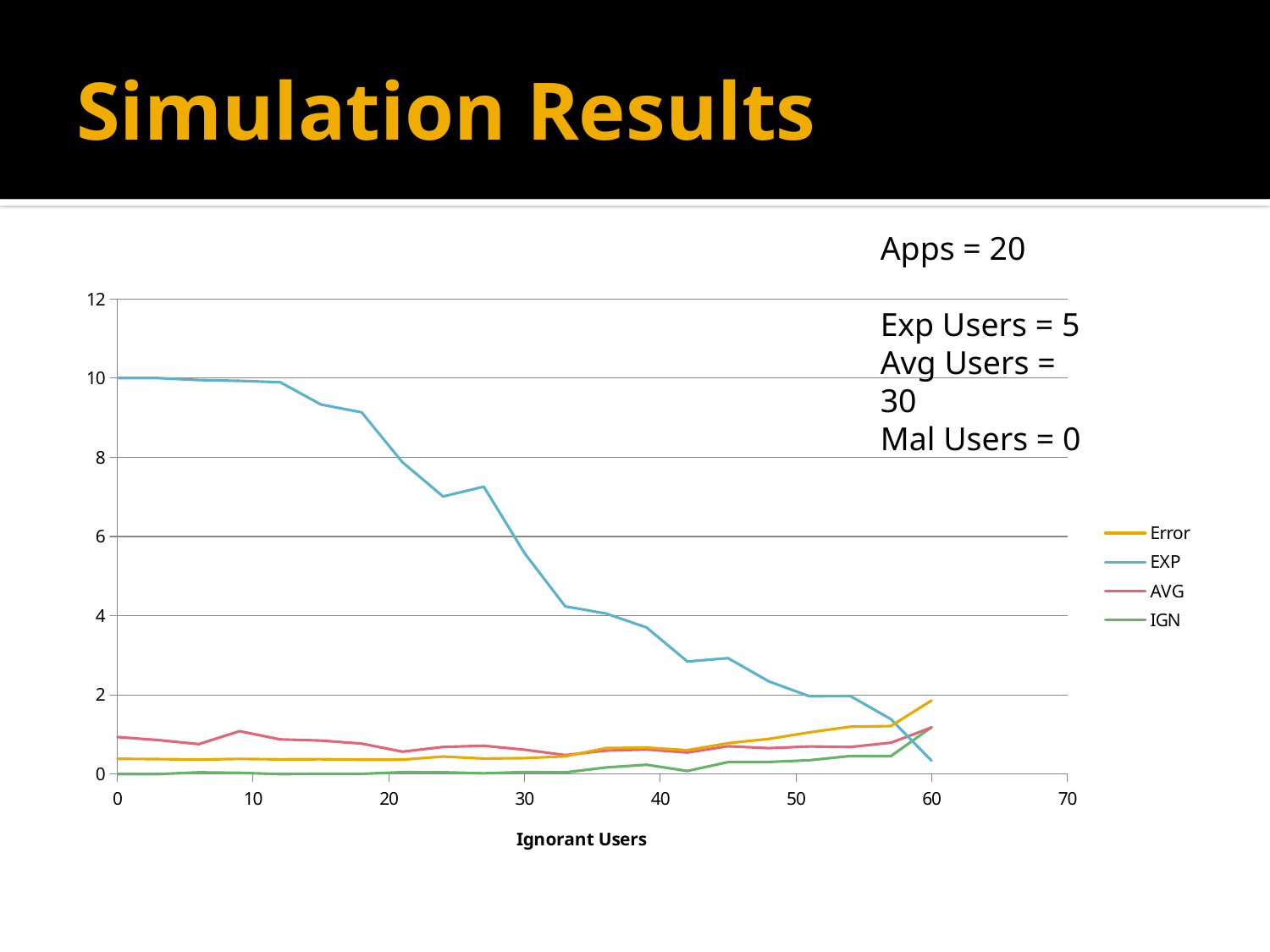
Is the IGN value at 0 Ignorant Users greater or less than 2? less Does the Error line rise or fall between 40 and 60 Ignorant Users? rise Is the EXP value at 60 Ignorant Users greater or less than 2? less Is the EXP value at 30 Ignorant Users greater or less than 4? greater What kind of chart is shown on the slide? line chart How many series does the legend list? 4 At 20 Ignorant Users, which is larger, the EXP value or the Error value? EXP Does the EXP line rise or fall as Ignorant Users increases from 0 to 60? fall What are the series names listed in the legend? Error, EXP, AVG, IGN At 0 Ignorant Users, which series has the highest value? EXP What is the title of the x axis? Ignorant Users